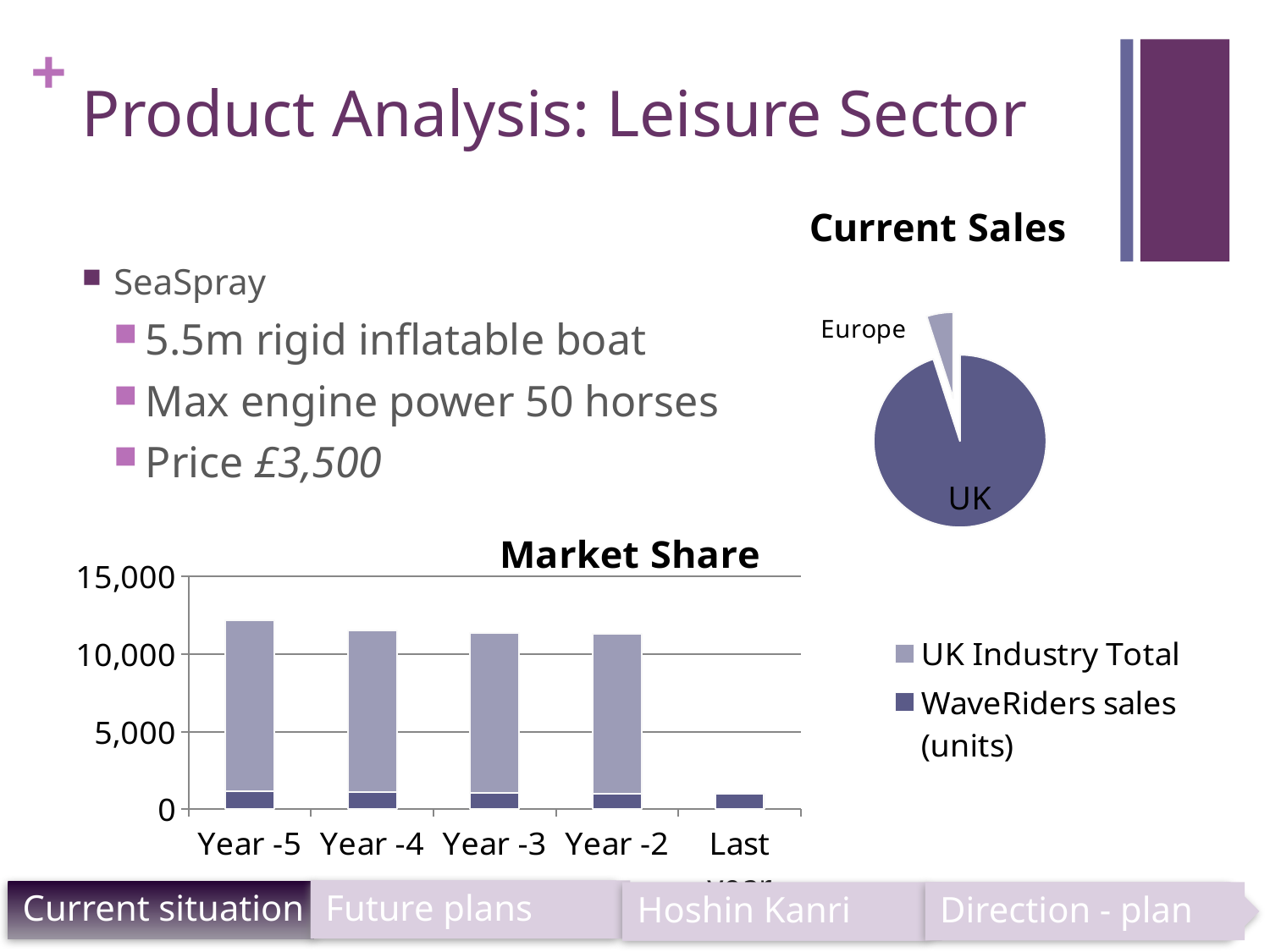
What kind of chart is the Current Sales chart? pie chart In the Market Share chart, which category has the lowest total bar? Last year In the Market Share chart, is the total bar for Year -5 greater or less than 10,000? greater In the Current Sales pie chart, which slice is larger, UK or Europe? UK How many slices does the Current Sales pie chart have? 2 How many series does the legend of the Market Share chart list? 2 How many categories are shown on the x axis of the Market Share chart? 5 In the Market Share chart, does the UK Industry Total rise or fall from Year -5 to Year -2? fall In the Market Share chart, which is larger, the total bar for Year -2 or the total bar for Last year? Year -2 In the Market Share chart, is the total bar for Last year greater or less than 5,000? less What kind of chart is the Market Share chart? bar chart What are the two series named in the legend of the Market Share chart? UK Industry Total and WaveRiders sales (units)